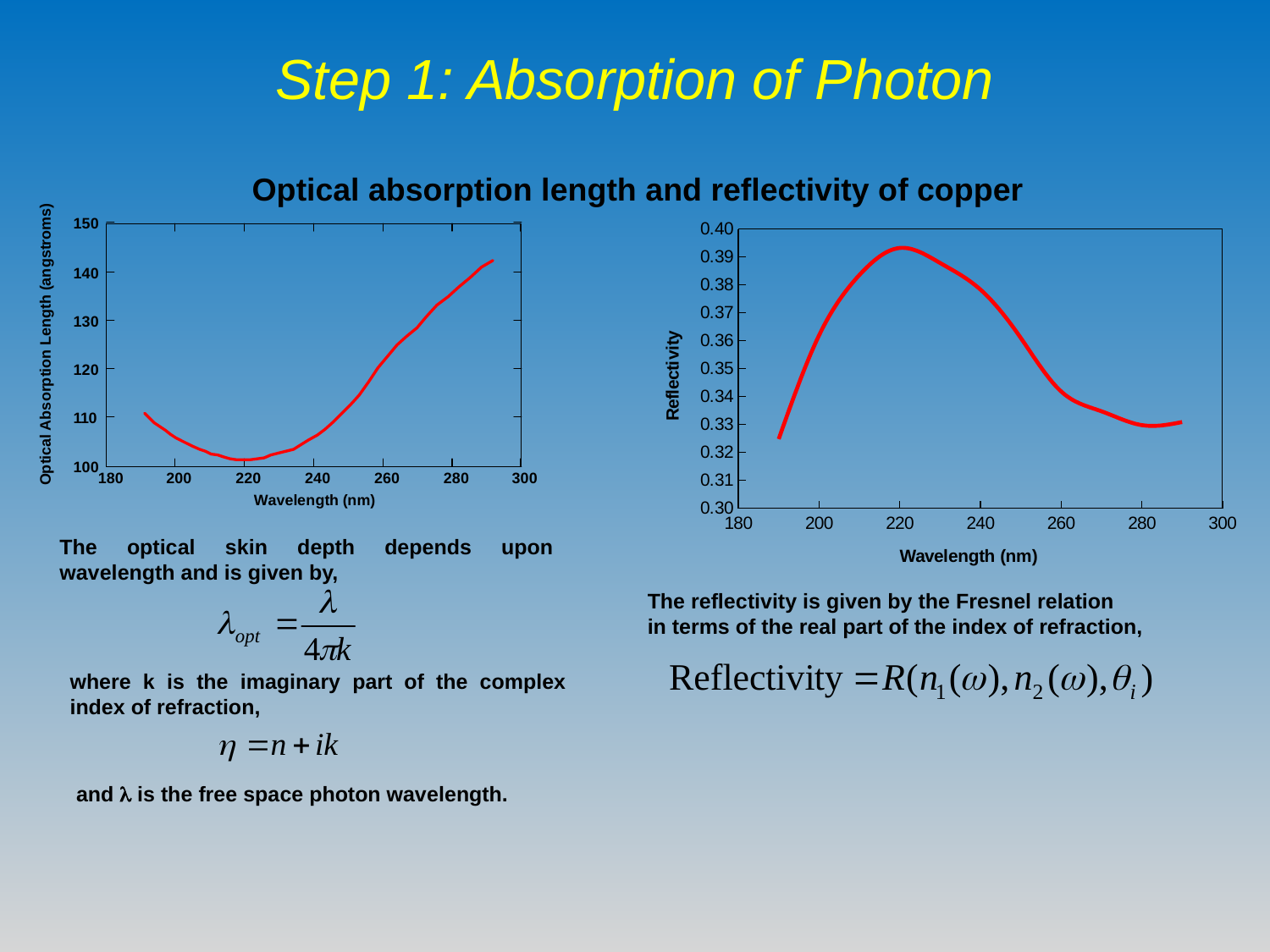
What kind of chart is the left chart showing optical absorption length? line chart On the right chart (Reflectivity), is the value at 290 nm greater or less than 0.34? less On the left chart (Optical Absorption Length), is the value at 220 nm greater or less than 110? less On the right chart (Reflectivity), is the value at 190 nm greater or less than 0.34? less On the right chart (Reflectivity), do the values rise or fall as wavelength increases from 220 nm to 290 nm? fall What is the x-axis label on the right chart (Reflectivity)? Wavelength (nm) What is the y-axis label on the left chart? Optical Absorption Length (angstroms) On the left chart (Optical Absorption Length), do the values rise or fall as wavelength increases from 220 nm to 290 nm? rise What kind of chart is the right chart showing reflectivity? line chart